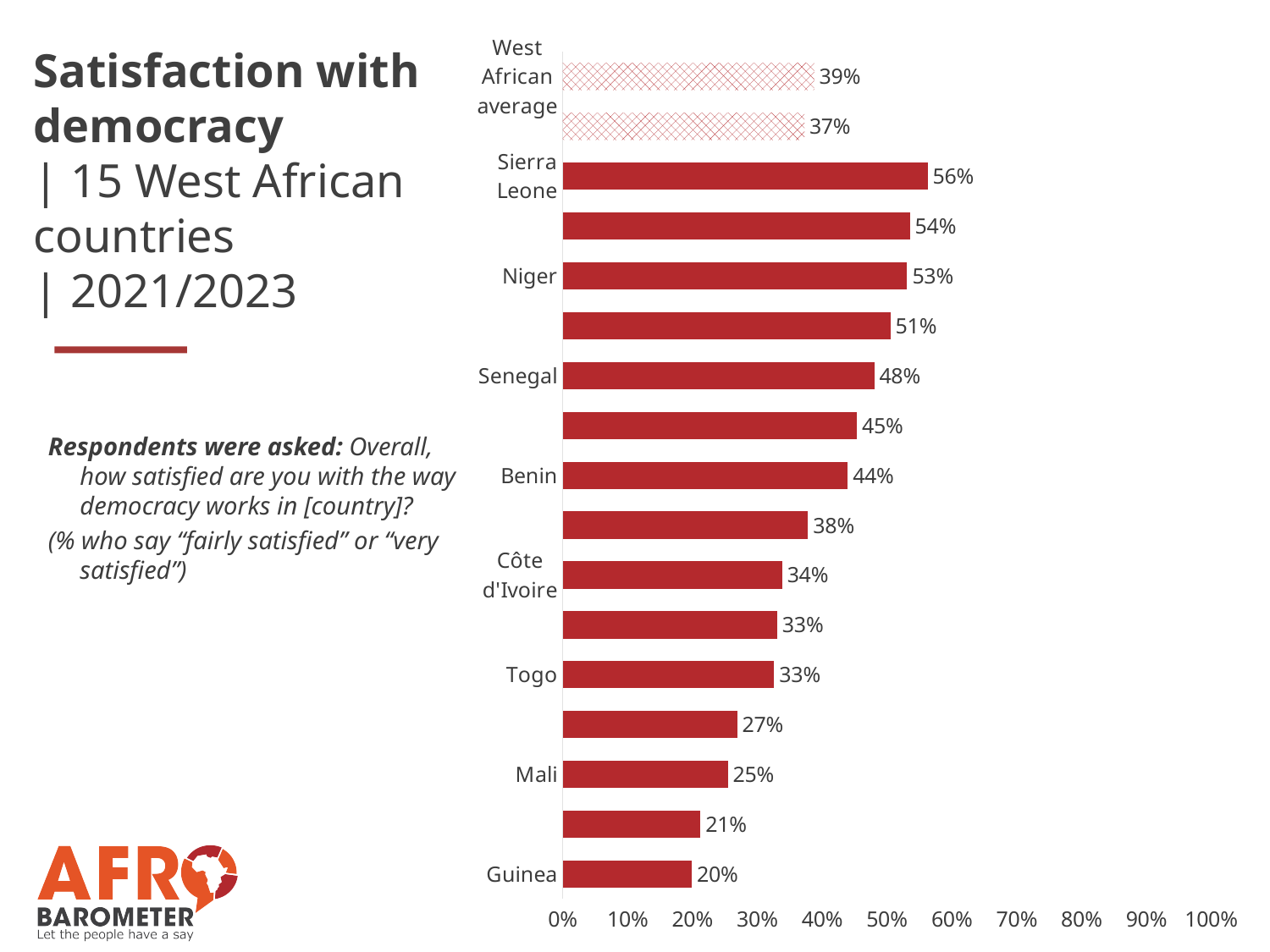
What is the value for Sierra Leone? 56% What is the value for Senegal? 48% What is the value for Côte d'Ivoire? 34% What is the value for Guinea? 20% What kind of chart is shown on the slide? Bar chart What is the value for Niger? 53% Which country has the highest satisfaction with democracy? Sierra Leone Which country has the lowest satisfaction with democracy? Guinea What is the difference between the values for Sierra Leone and Guinea? 36 percentage points What is the value for Mali? 25% Which has a higher value, Senegal or Benin? Senegal What is the value for Benin? 44%